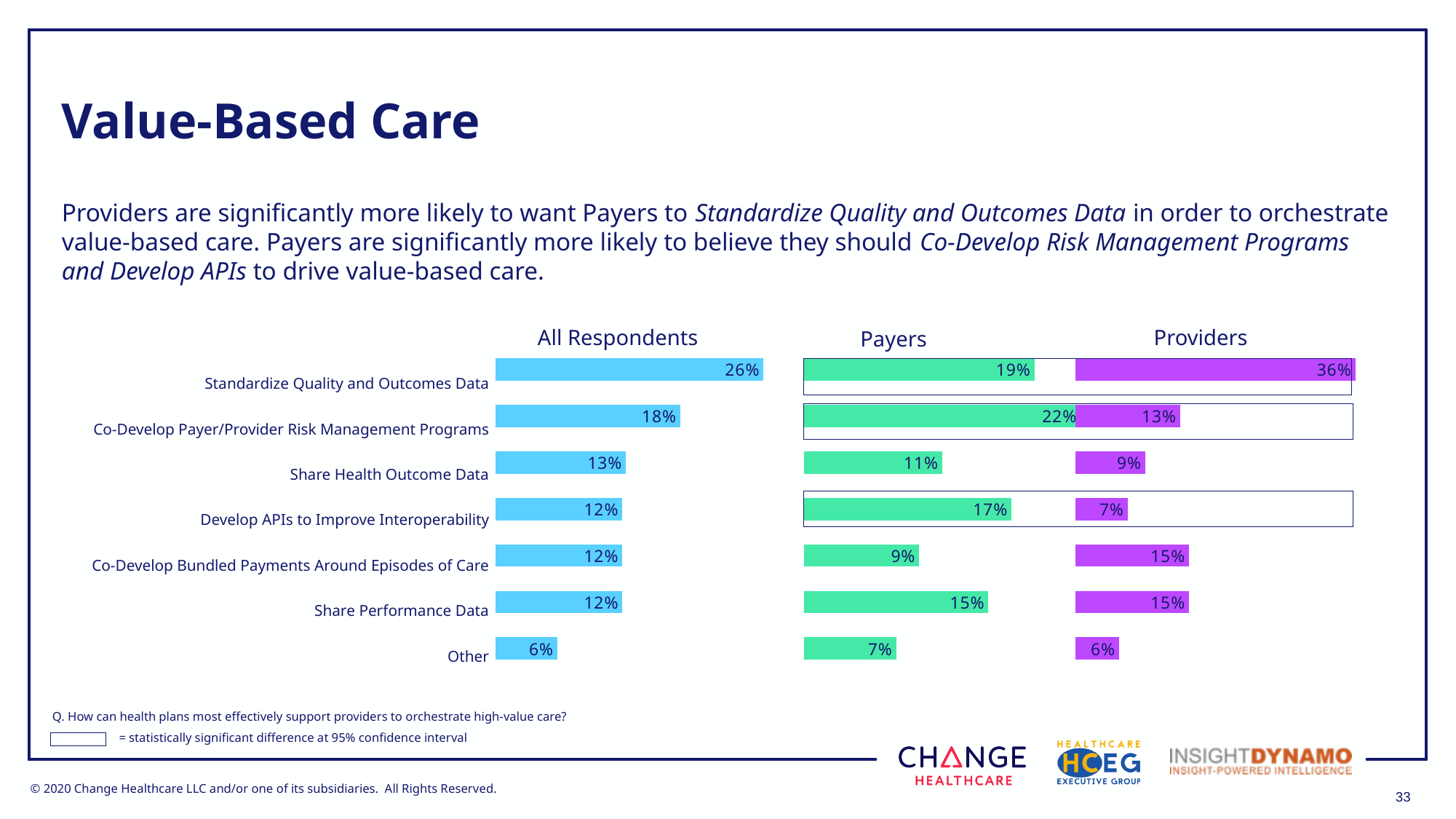
In the Providers chart, what is the value for Co-Develop Payer/Provider Risk Management Programs? 13% In the Payers chart, which category has the highest value? Co-Develop Payer/Provider Risk Management Programs For Co-Develop Bundled Payments Around Episodes of Care, which is larger: the Payers value or the Providers value? Providers What type of chart is used to show the All Respondents data? Bar chart In the Payers chart, which category has the lowest value? Other What is the difference between the Providers and Payers values for Standardize Quality and Outcomes Data? 17% In the Payers chart, what is the value for Develop APIs to Improve Interoperability? 17% How many separate charts are shown on the slide? 3 In the All Respondents chart, what is the value for Standardize Quality and Outcomes Data? 26% How many categories are shown in the All Respondents chart? 7 What is the difference between the Payers and Providers values for Develop APIs to Improve Interoperability? 10% In the Providers chart, which category has the highest value? Standardize Quality and Outcomes Data